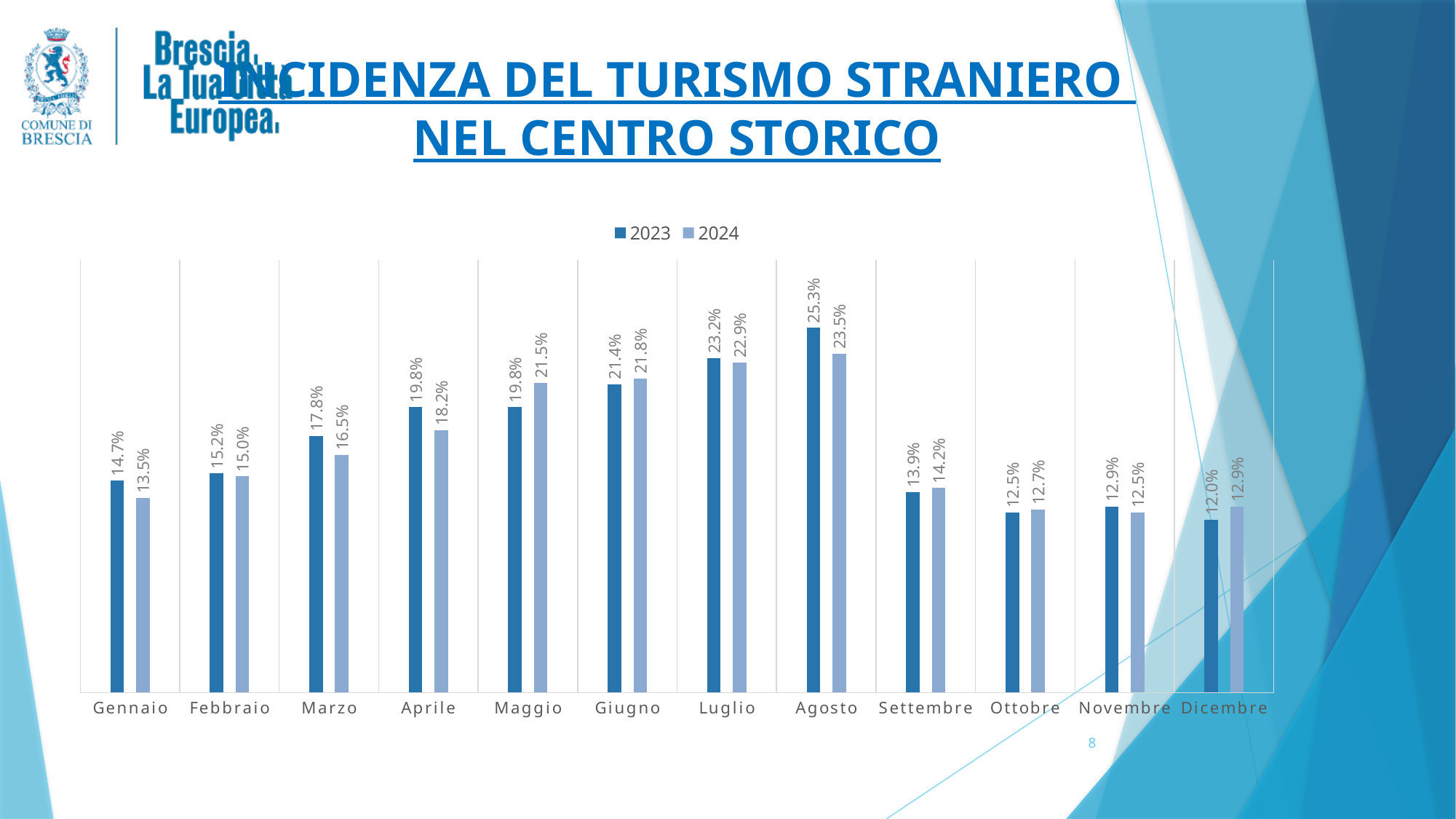
What is the value for 2024 in Dicembre? 12.9% What is the difference between the 2023 and 2024 values in Marzo? 1.3% Which month has the highest value for the 2024 series? Agosto Which is larger in Gennaio, the 2023 value or the 2024 value? 2023 Do the 2023 values rise or fall from Agosto to Settembre? Fall What kind of chart is shown on the slide? Bar chart What is the value for 2023 in Agosto? 25.3% Which is larger in Maggio, the 2023 value or the 2024 value? 2024 How many series does the legend list? 2 How many months are shown on the x axis? 12 What is the value for 2024 in Aprile? 18.2% Which month has the lowest value for the 2023 series? Dicembre